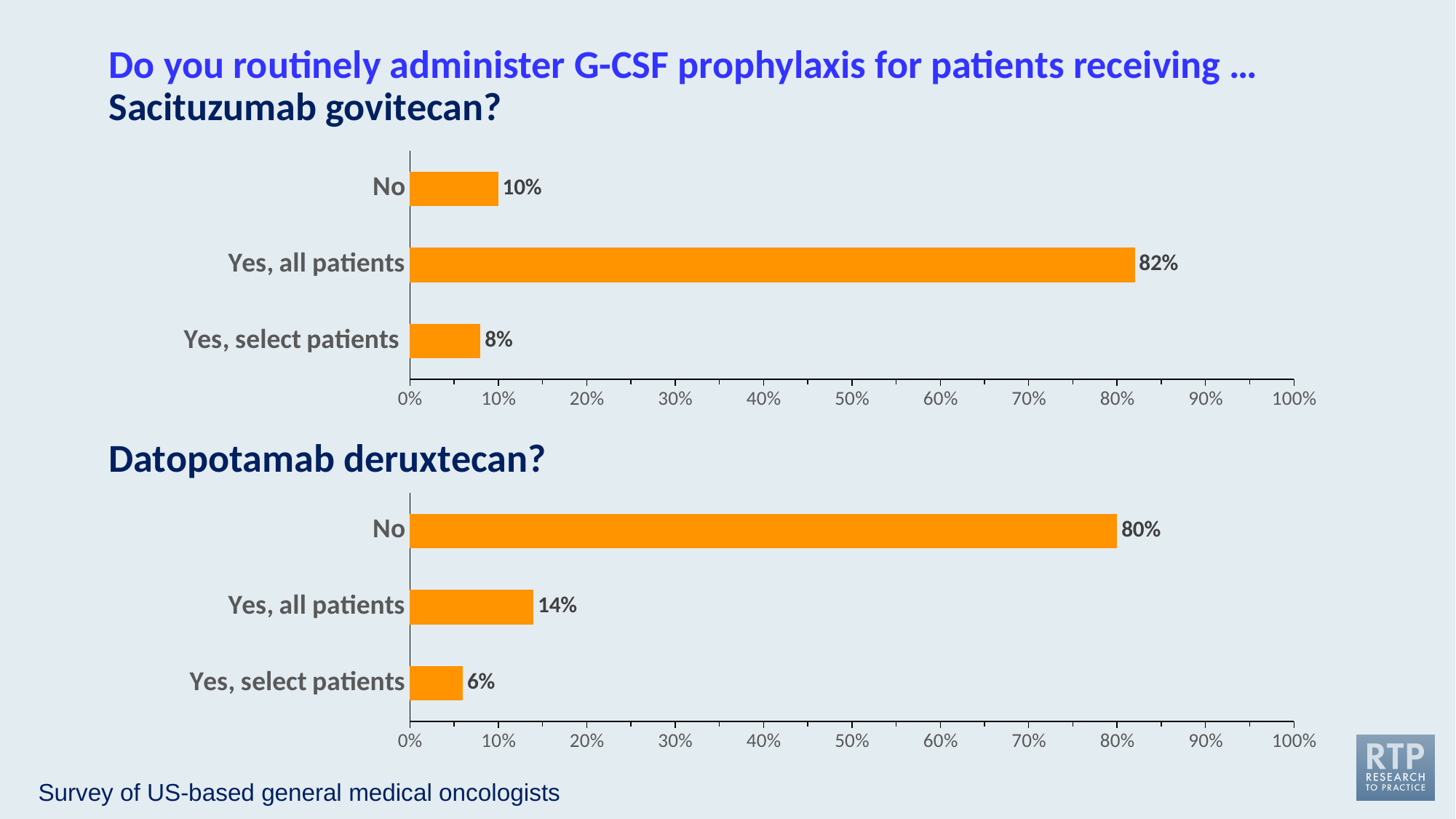
In the Sacituzumab govitecan chart, what is the difference between the "No" and "Yes, select patients" percentages? 2% In the Datopotamab deruxtecan chart, which response has the lowest percentage? Yes, select patients In the Sacituzumab govitecan chart, which response has the highest percentage? Yes, all patients In the Datopotamab deruxtecan chart, what percentage answered "Yes, select patients"? 6% How many response categories are shown in the Datopotamab deruxtecan chart? 3 In the Datopotamab deruxtecan chart, what is the difference between the "No" and "Yes, all patients" percentages? 66% In the Sacituzumab govitecan chart, what percentage answered "Yes, all patients"? 82% In the Datopotamab deruxtecan chart, what percentage answered "No"? 80% In the Sacituzumab govitecan chart, what percentage answered "No"? 10% What type of chart is used for the Sacituzumab govitecan data? Bar chart What is the maximum value shown on the x axis of the Datopotamab deruxtecan chart? 100% Which is larger: "Yes, all patients" in the Sacituzumab govitecan chart or "No" in the Datopotamab deruxtecan chart? Yes, all patients in the Sacituzumab govitecan chart